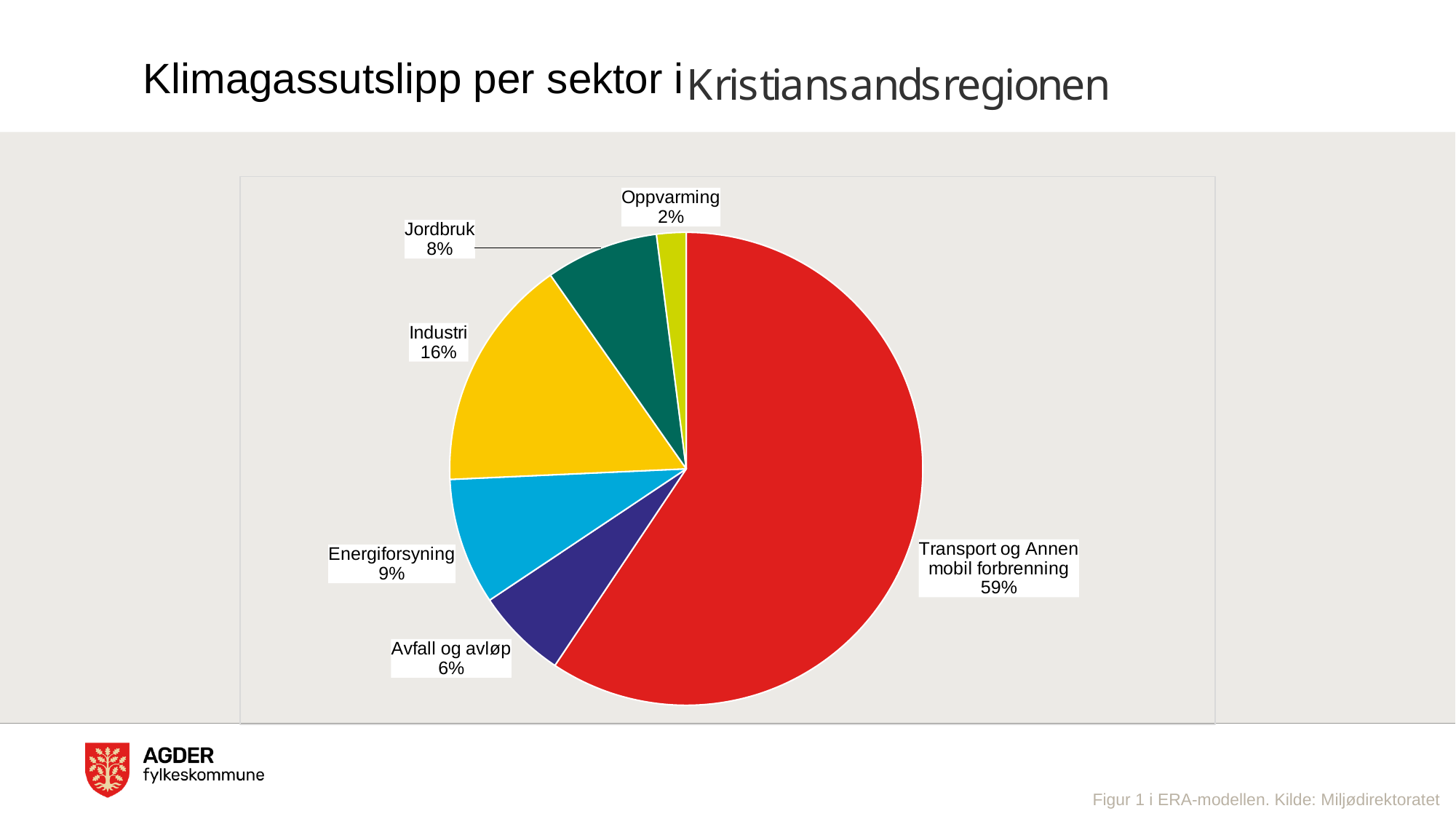
Which has a larger share, Jordbruk or Avfall og avløp? Jordbruk What is the difference in percentage points between Industri and Energiforsyning? 7 What share of the pie does Avfall og avløp have? 6% What share of the pie does Oppvarming have? 2% What kind of chart is shown on the slide? Pie chart How many sectors are shown in the pie chart? 6 What share of the pie does Industri have? 16% Which sector has the smallest share of the pie? Oppvarming Which sector has the largest share of the pie? Transport og Annen mobil forbrenning